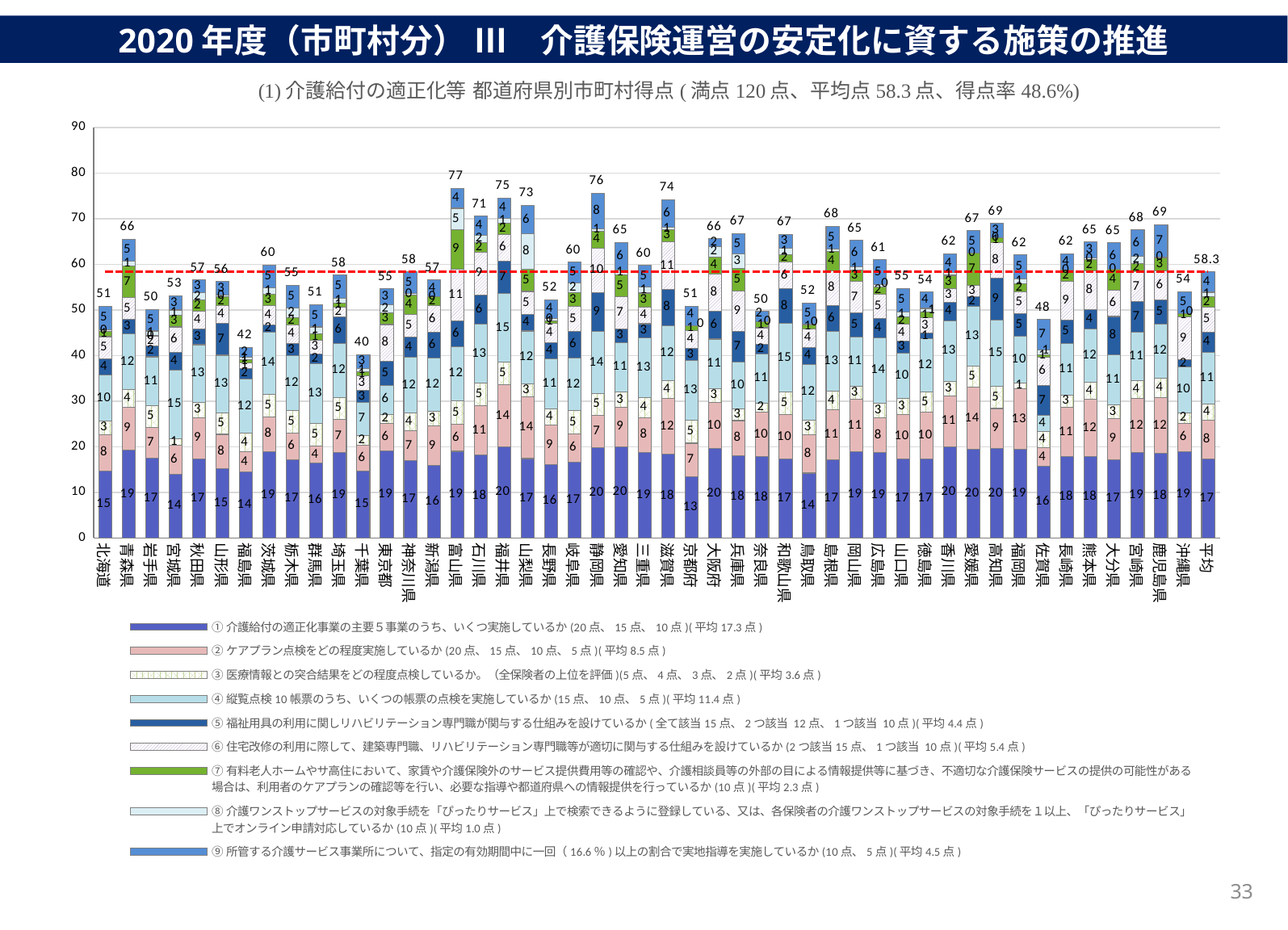
How many bars are plotted in the chart, including the 平均 bar? 48 What is the value of the bottom segment (series ①) for 福井県? 20 Is the total score for 京都府 greater or less than 60? less What is the total score shown for 静岡県? 76 What is the difference between the total score of 富山県 and that of 千葉県? 37 What value does the 平均 bar at the right end of the chart show? 58.3 Which has a higher total score, 滋賀県 or 石川県? 滋賀県 How many series does the legend list? 9 Which prefecture has the lowest total score in the chart? 千葉県 Which prefecture has the highest total score in the chart? 富山県 What kind of chart is shown on the slide? stacked bar chart What is the total score shown for 福島県? 42